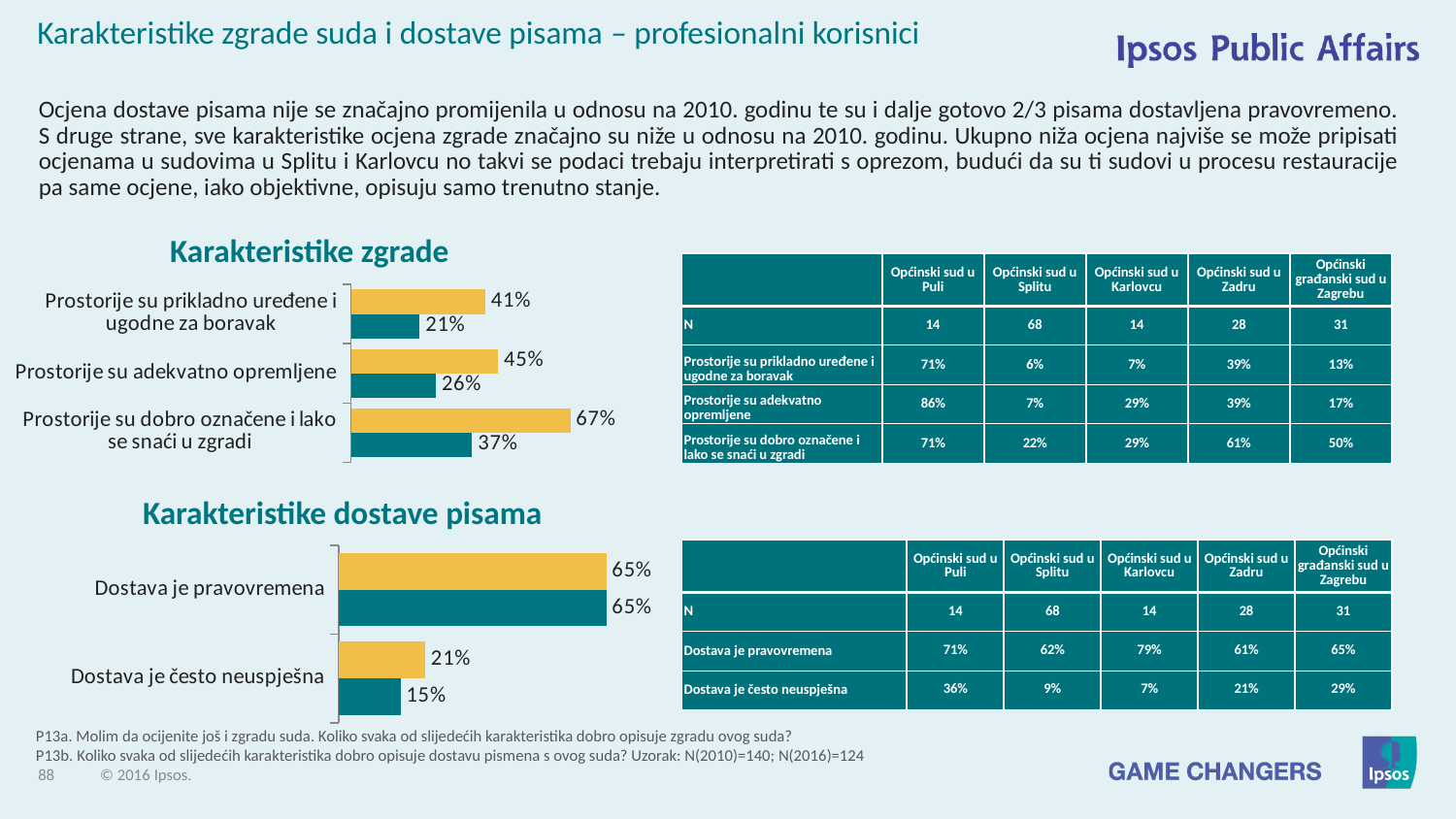
In the 'Karakteristike dostave pisama' chart, which is larger: the yellow bar for 'Dostava je pravovremena' or the yellow bar for 'Dostava je često neuspješna'? Dostava je pravovremena In the 'Karakteristike zgrade' chart, what is the value of the yellow bar for 'Prostorije su dobro označene i lako se snaći u zgradi'? 67% In the 'Karakteristike zgrade' chart, what is the value of the teal bar for 'Prostorije su prikladno uređene i ugodne za boravak'? 21% In the 'Karakteristike dostave pisama' chart, what is the value of the teal bar for 'Dostava je često neuspješna'? 15% In the 'Karakteristike zgrade' chart, how many categories are shown? 3 In the 'Karakteristike zgrade' chart, which category has the lowest teal bar? Prostorije su prikladno uređene i ugodne za boravak In the 'Karakteristike zgrade' chart, what is the difference between the yellow and teal bars for 'Prostorije su dobro označene i lako se snaći u zgradi'? 30% In the 'Karakteristike zgrade' chart, what is the value of the teal bar for 'Prostorije su adekvatno opremljene'? 26% In the 'Karakteristike zgrade' chart, which category has the highest yellow bar? Prostorije su dobro označene i lako se snaći u zgradi In the 'Karakteristike dostave pisama' chart, what is the difference between the yellow and teal bars for 'Dostava je često neuspješna'? 6% In the 'Karakteristike dostave pisama' chart, what is the value of the yellow bar for 'Dostava je pravovremena'? 65% What type of chart is the 'Karakteristike dostave pisama' chart? Bar chart